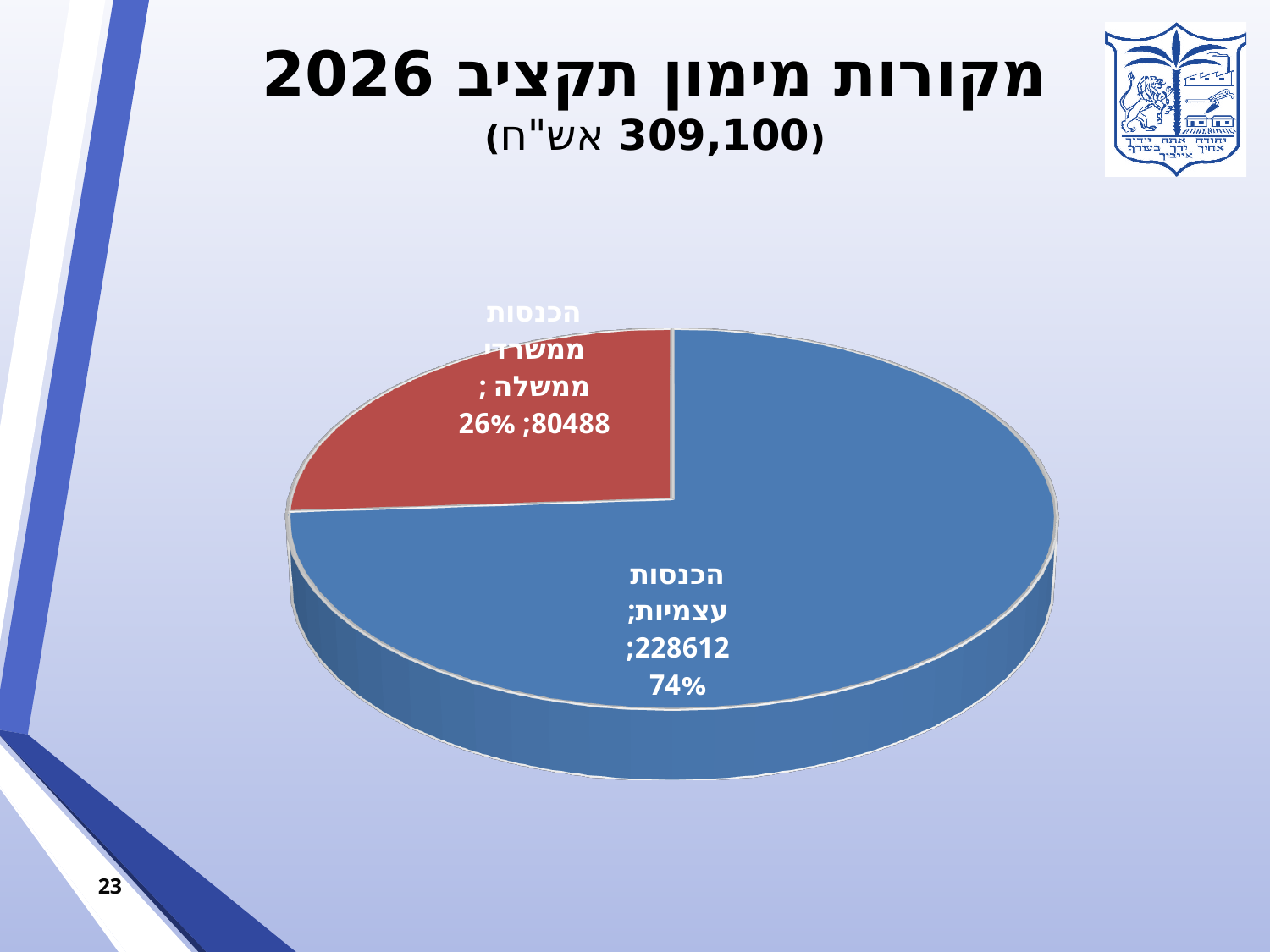
Which is larger, הכנסות עצמיות or הכנסות ממשרדי ממשלה? הכנסות עצמיות What is the value shown for הכנסות ממשרדי ממשלה? 80488 Which category has the largest slice of the pie? הכנסות עצמיות What kind of chart is shown on the slide? Pie chart What colour is the slice for הכנסות ממשרדי ממשלה? Red What is the difference between the values for הכנסות עצמיות and הכנסות ממשרדי ממשלה? 148124 What share of the pie does הכנסות ממשרדי ממשלה represent? 26% What is the value shown for הכנסות עצמיות? 228612 How many slices does the pie chart have? 2 What is the title of the chart on the slide? מקורות מימון תקציב 2026 (309,100 אש"ח) Which category has the smallest slice of the pie? הכנסות ממשרדי ממשלה What share of the pie does הכנסות עצמיות represent? 74%